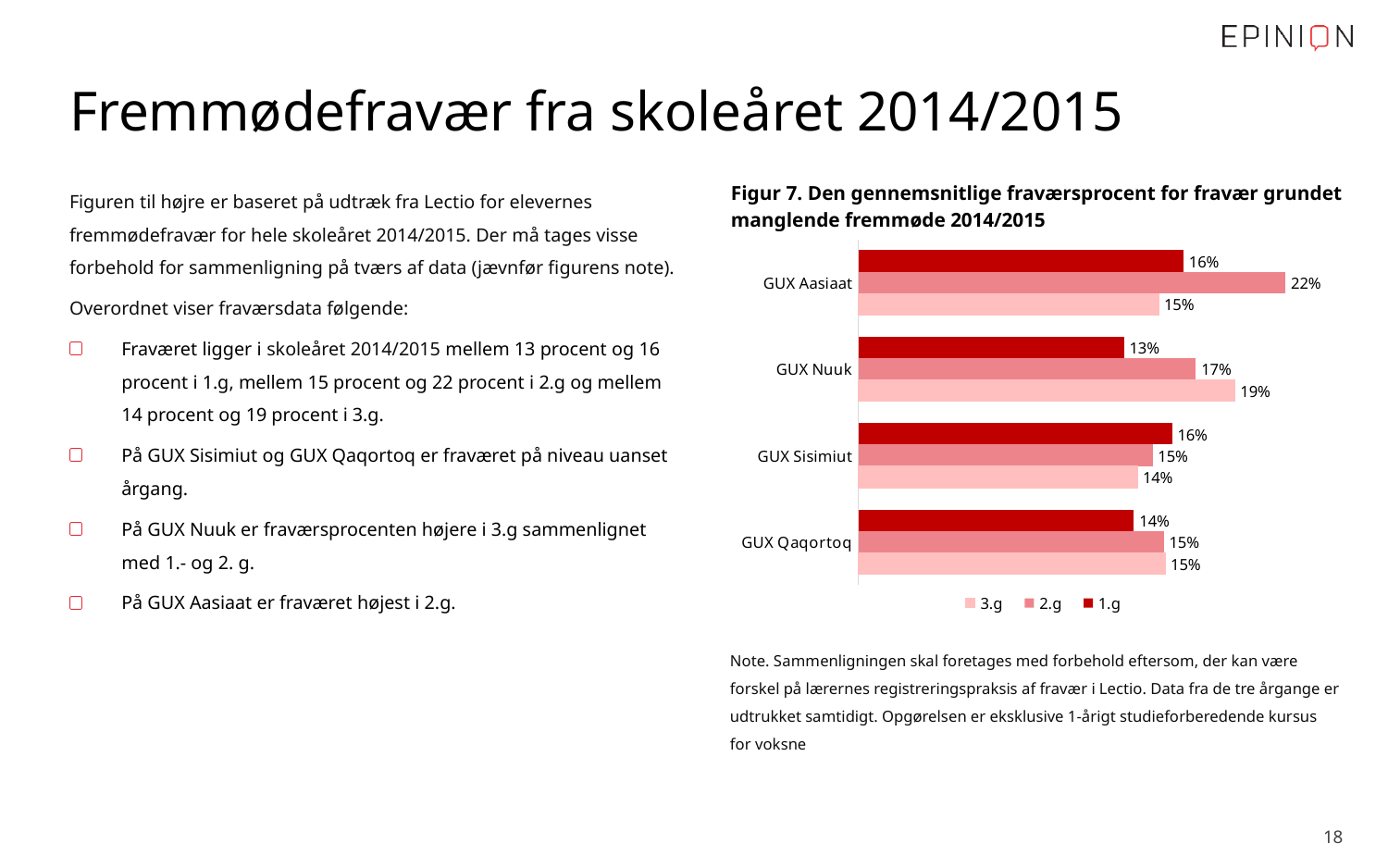
Which is larger for GUX Nuuk: the 3.g absence rate or the 1.g absence rate? 3.g What is the difference between the 2.g and 1.g absence rates for GUX Aasiaat? 6 percentage points What is the 3.g absence rate for GUX Sisimiut? 14% What is the 1.g absence rate for GUX Qaqortoq? 14% Which school has the highest 2.g absence rate? GUX Aasiaat How many series does the legend list? 3 Which school has the lowest 1.g absence rate? GUX Nuuk Which series is shown in the darkest red colour? 1.g What kind of chart is shown on the slide? Bar chart What is the 1.g absence rate for GUX Nuuk? 13% What is the 2.g absence rate for GUX Aasiaat? 22% How many schools are shown in the chart? 4